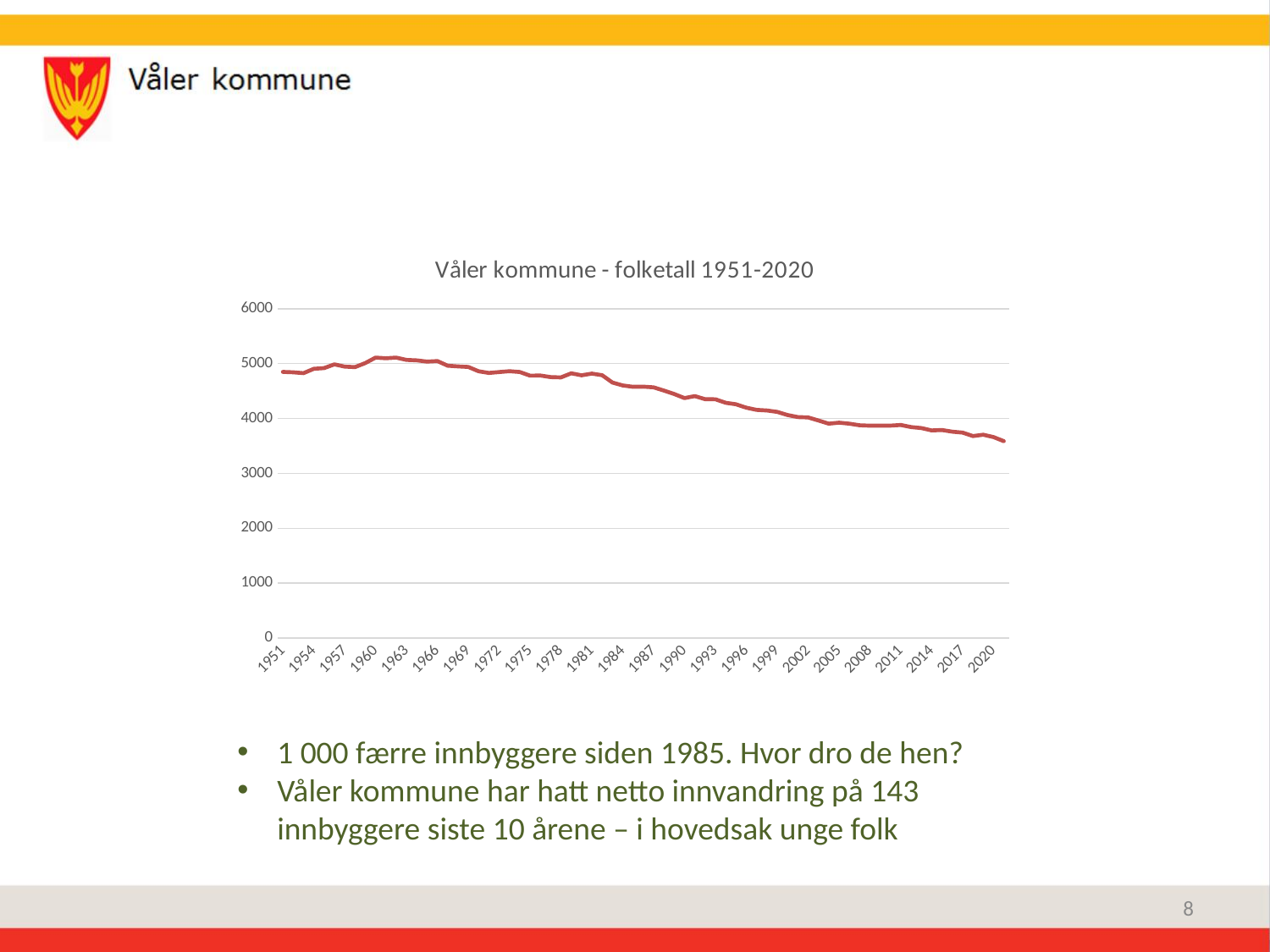
Is the value for 2020 greater or less than 3000? greater Is the value for 2020 greater or less than 4000? less What is the highest value shown on the vertical axis? 6000 Does the population value generally rise or fall from 1951 to 2020? fall Is the value for 1951 greater or less than 4000? greater What kind of chart is shown on the slide? line chart Which is larger, the value for 1960 or the value for 2005? 1960 How many lines are plotted on the chart? 1 What is the title of the chart? Våler kommune - folketall 1951-2020